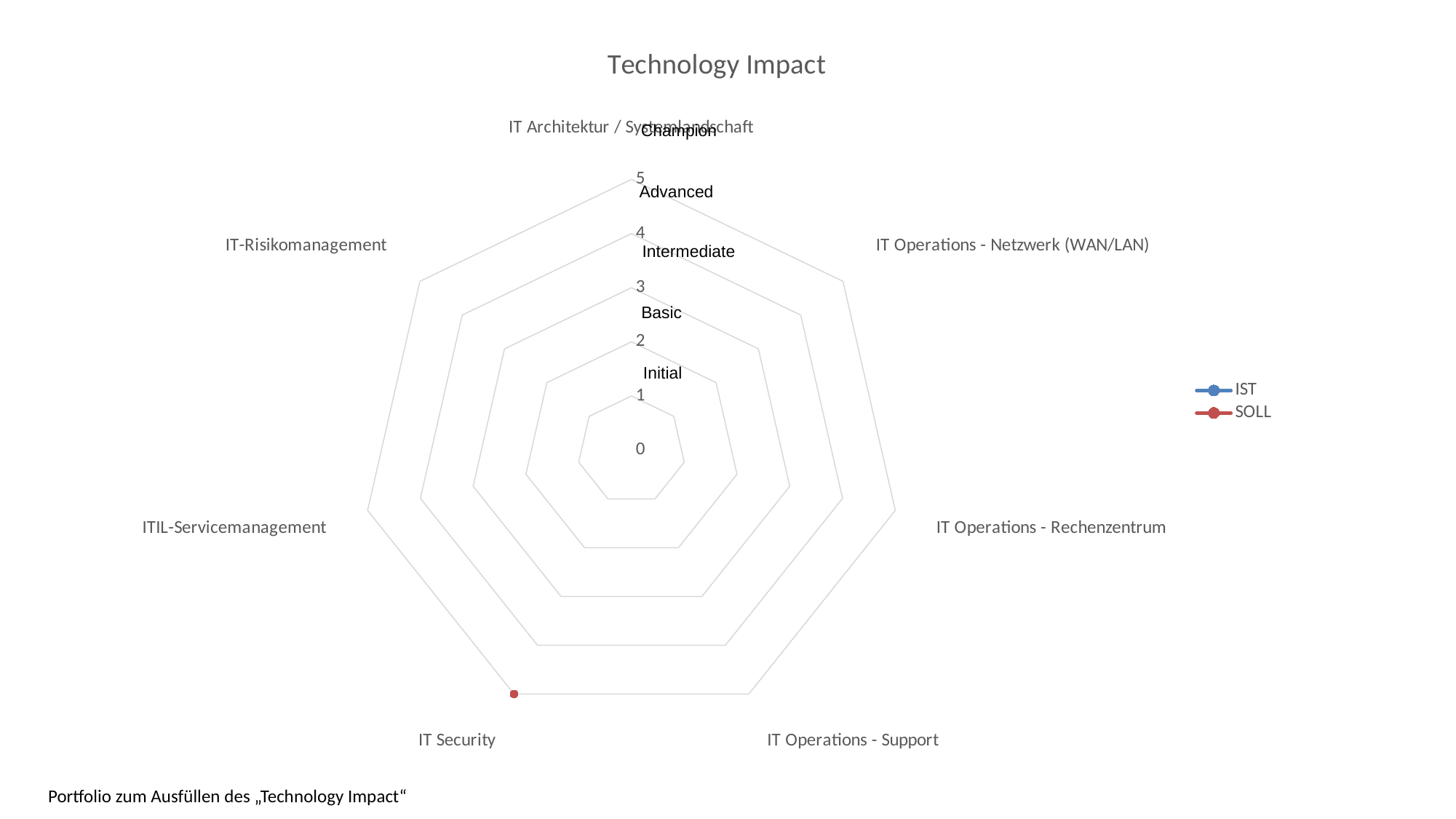
What is the SOLL value for IT Security? 5 Which category has a plotted SOLL data point? IT Security What is the title of the chart? Technology Impact How many series does the legend list? 2 What is the highest value shown on the chart's axis scale? 5 Which series are listed in the legend? IST and SOLL What kind of chart is shown on the slide? Radar chart Is the SOLL value for IT Security greater or less than 4? greater How many categories (axes) does the radar chart have? 7